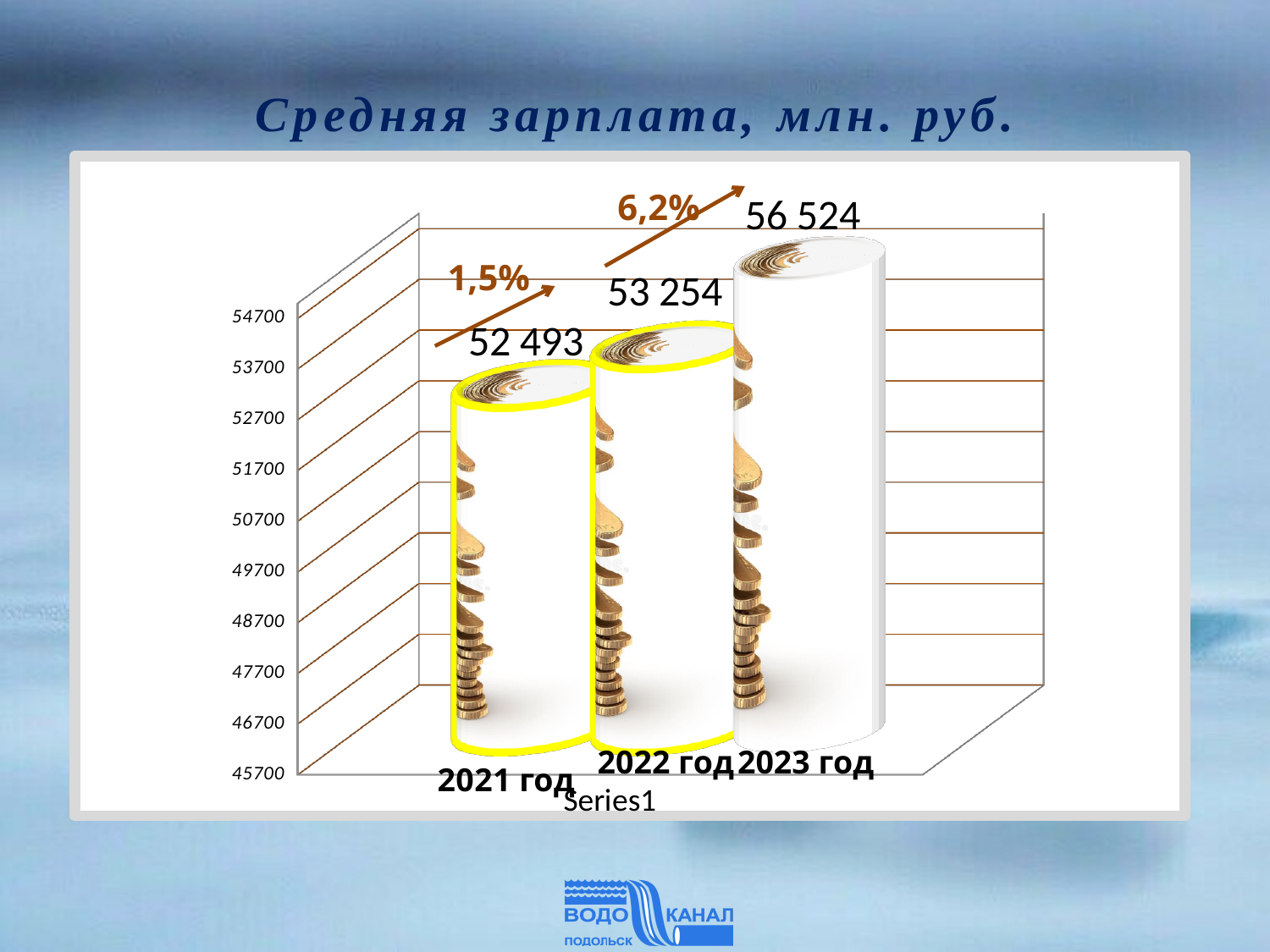
Which year has the lowest average salary? 2021 год Do the values rise or fall from 2021 год to 2023 год? rise What is the value for 2021 год? 52 493 What is the difference between the values for 2022 год and 2021 год? 761 What percentage growth is labelled between 2022 год and 2023 год? 6,2% What is the value for 2022 год? 53 254 Which is larger, the value for 2022 год or the value for 2021 год? 2022 год Which year has the highest average salary? 2023 год What kind of chart is shown on the slide? bar chart What is the difference between the values for 2023 год and 2022 год? 3 270 What is the value for 2023 год? 56 524 How many years are shown on the chart? 3